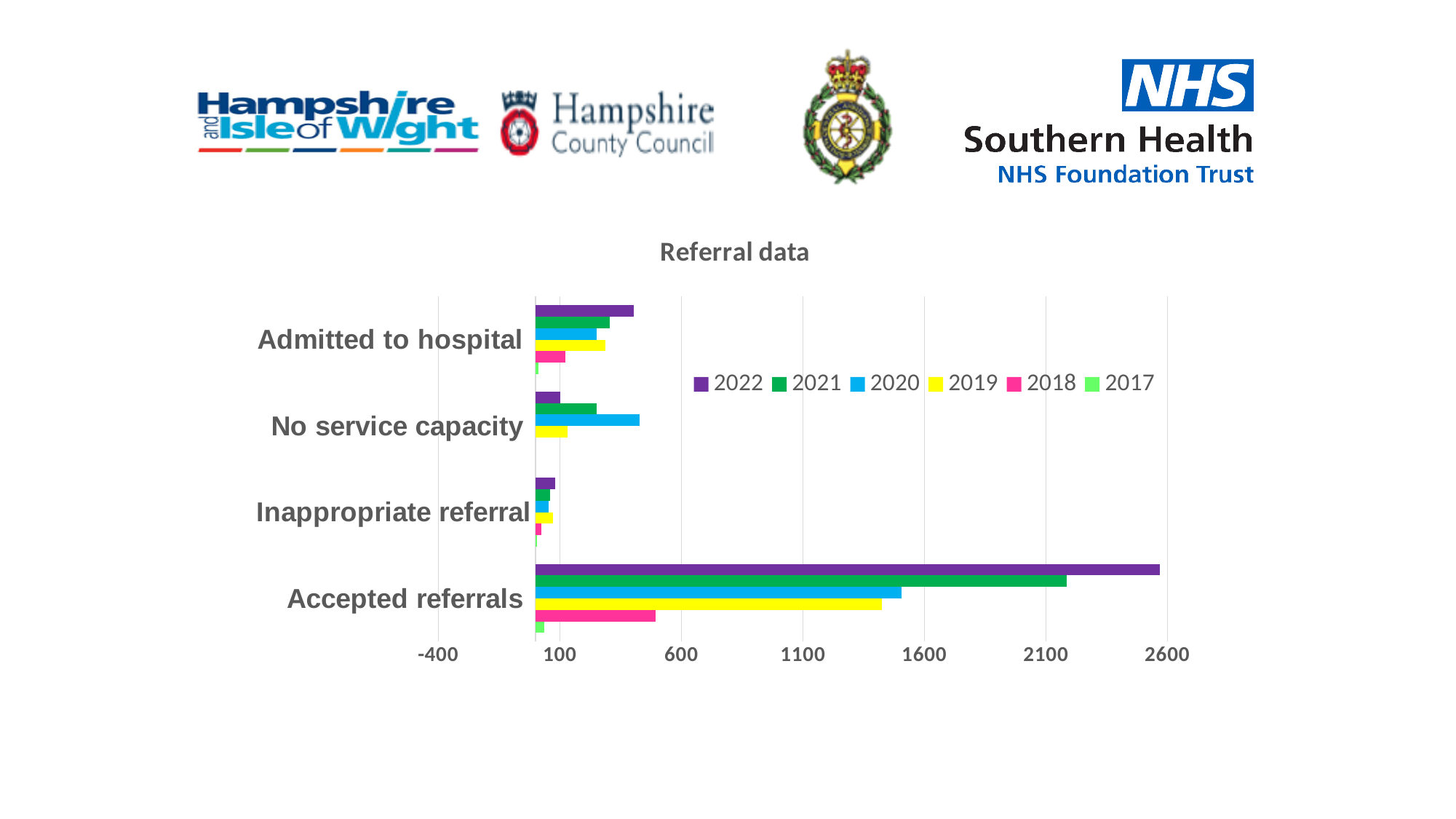
Is the value for Accepted referrals in 2022 greater or less than 2100? greater For Admitted to hospital, which is larger: the value for 2022 or the value for 2021? 2022 Is the value for Accepted referrals in 2021 greater or less than 1600? greater Is the value for Accepted referrals in 2018 greater or less than 600? less Which year has the highest value for Accepted referrals? 2022 What kind of chart is shown on the slide? bar chart For No service capacity, which is larger: the value for 2020 or the value for 2021? 2020 How many categories are shown on the Referral data chart? 4 What is the title of the chart? Referral data Which year has the highest value for No service capacity? 2020 How many series does the legend of the Referral data chart list? 6 Which category has the longest bar on the chart? Accepted referrals